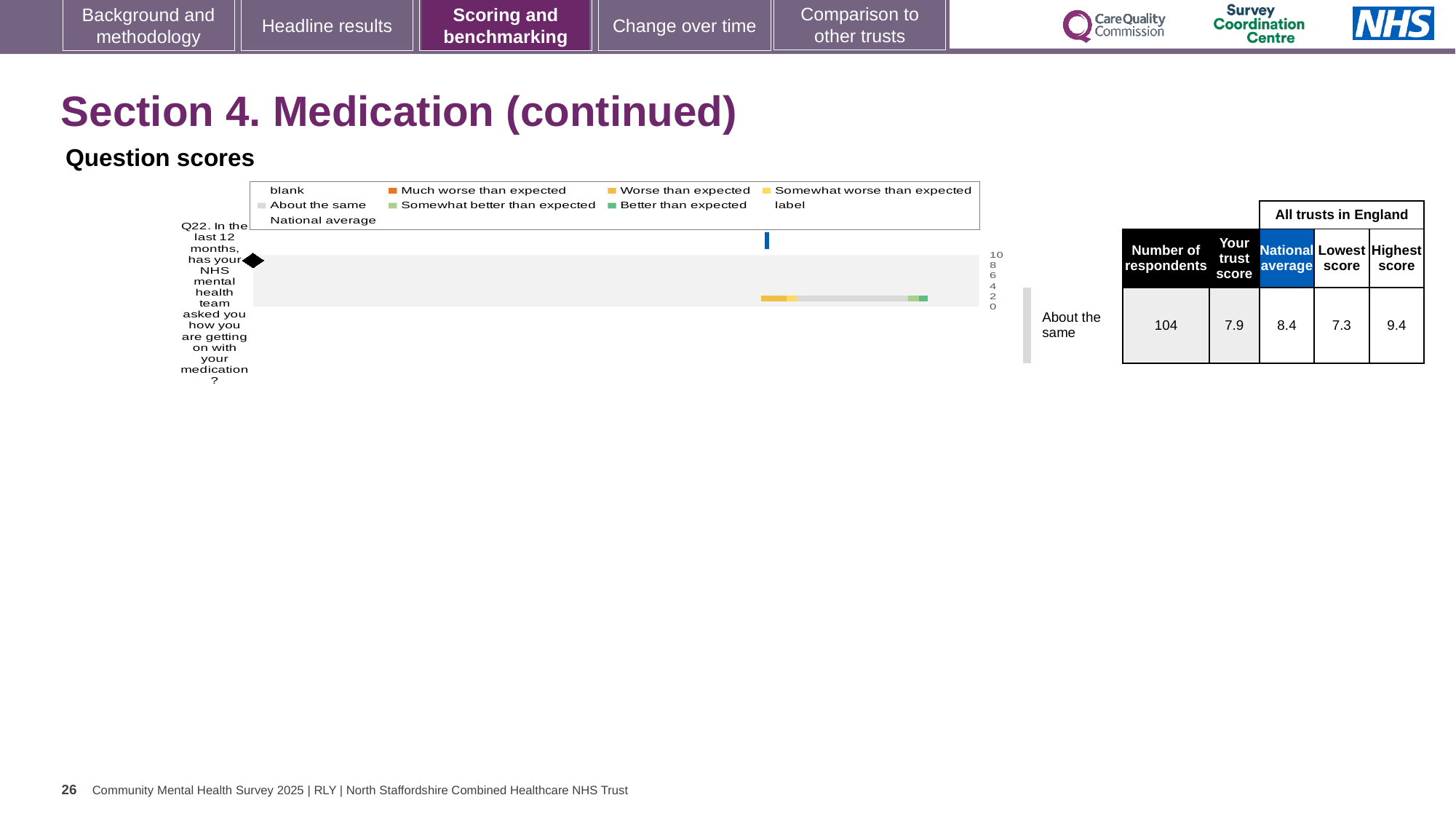
What benchmark category is shown for Q22 next to the chart? About the same In the table beside the chart, what is the highest score among all trusts in England for Q22? 9.4 In the table beside the chart, what is the lowest score among all trusts in England for Q22? 7.3 Which question is plotted in the Question scores chart? Q22. In the last 12 months, has your NHS mental health team asked you how you are getting on with your medication? How many questions are plotted in the Question scores chart? 1 How many entries does the legend of the Question scores chart list? 9 In the table beside the chart, what is the trust score for Q22? 7.9 In the table beside the chart, what is the number of respondents for Q22? 104 What kind of chart is shown under 'Question scores'? bar chart What is the difference between the highest score and the lowest score for Q22 in the table beside the chart? 2.1 In the table beside the chart, what is the national average for Q22? 8.4 Is the trust score for Q22 higher or lower than the national average? lower